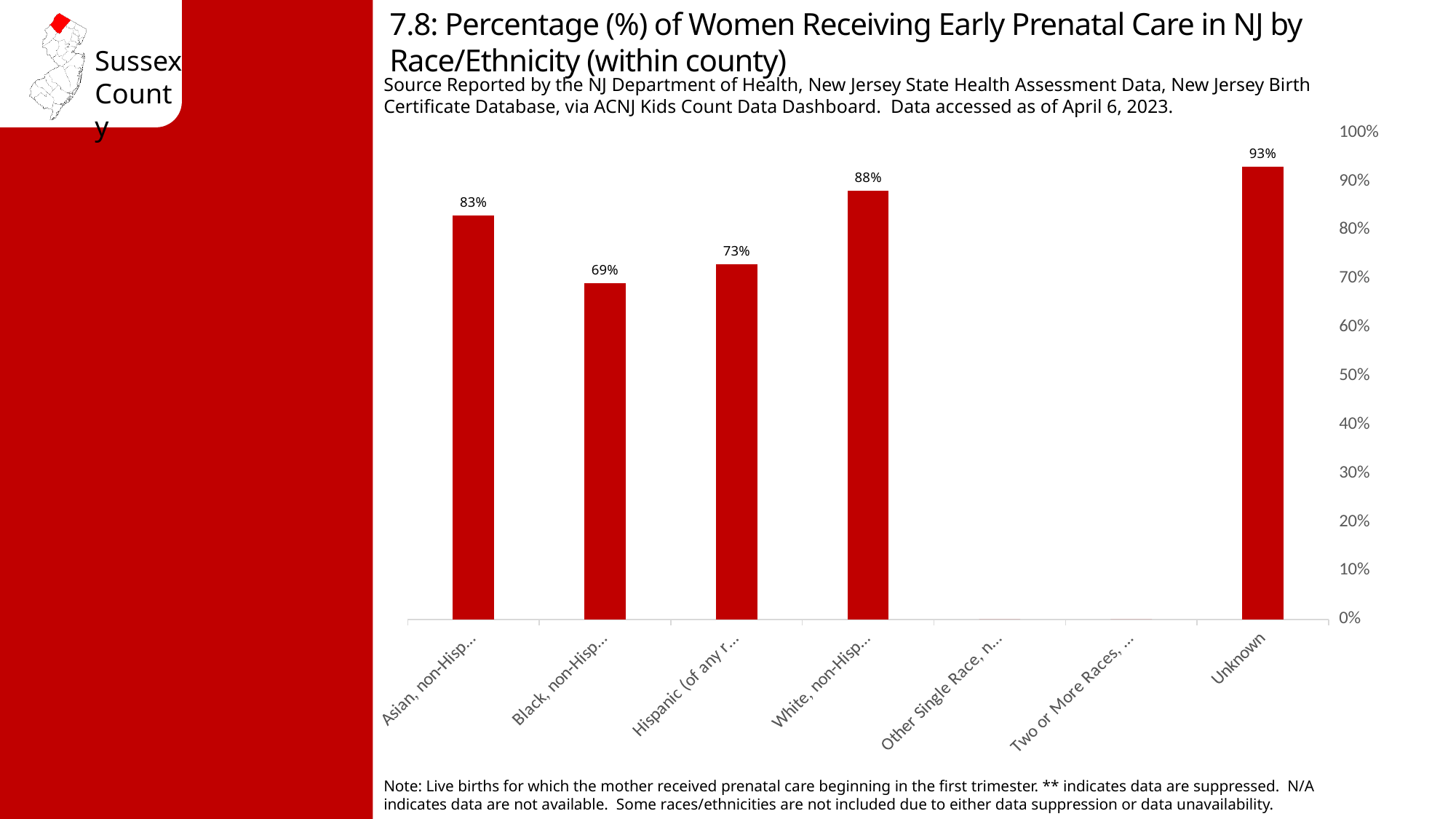
What kind of chart is shown on the slide? Bar chart What is the value for the Unknown category? 93% What is the difference between the Unknown value and the Asian, non-Hispanic value? 10 percentage points What is the value for Black, non-Hispanic women? 69% Which is larger, the value for Asian, non-Hispanic or the value for Hispanic (of any race)? Asian, non-Hispanic What is the value for Asian, non-Hispanic women? 83% What is the value for White, non-Hispanic women? 88% Among the bars with data labels, which category has the lowest percentage? Black, non-Hispanic What is the difference between the White, non-Hispanic value and the Black, non-Hispanic value? 19 percentage points How many categories are shown on the x axis? 7 Which category has the highest percentage? Unknown What is the value for Hispanic (of any race) women? 73%